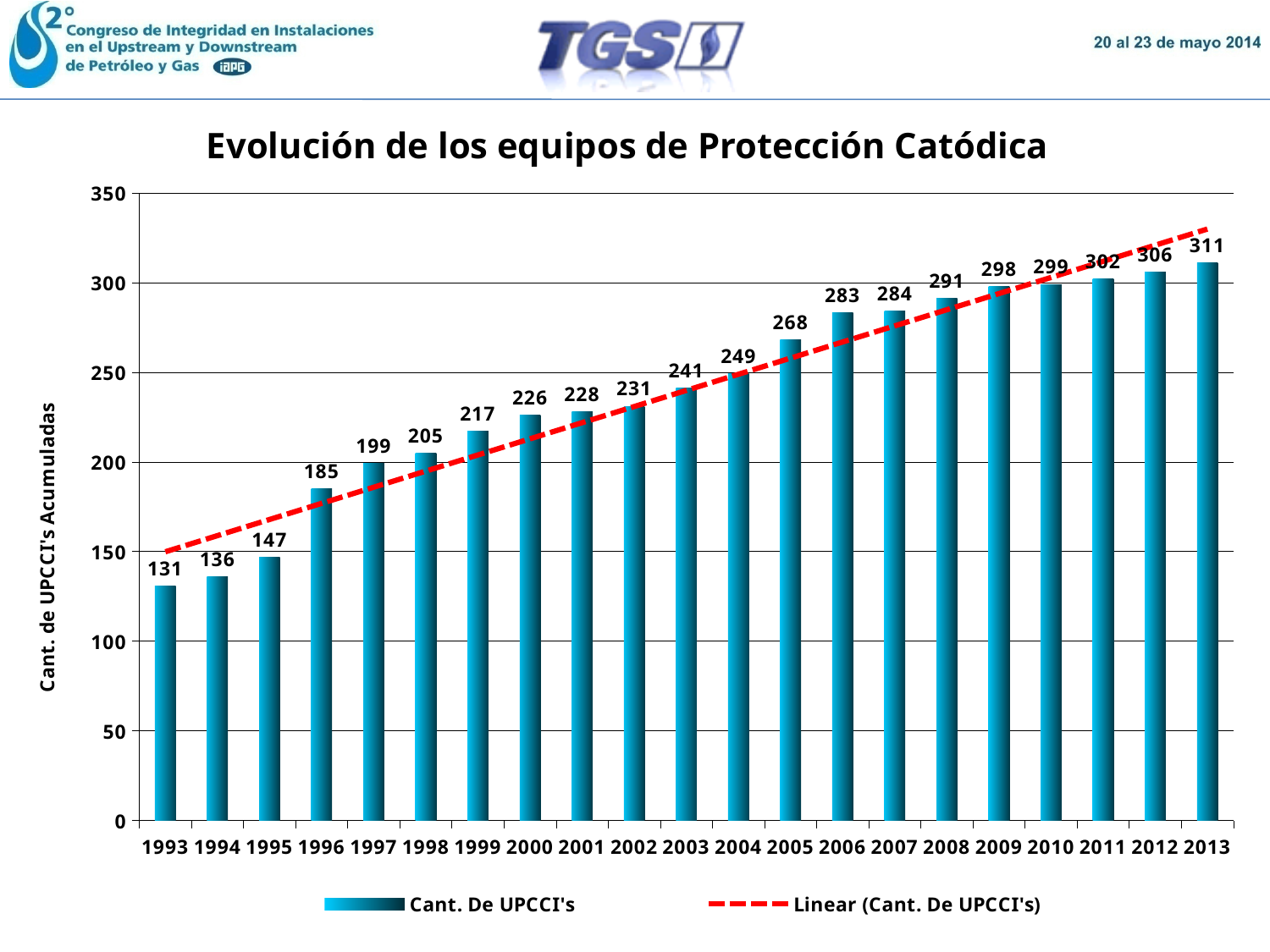
Which year has the lowest value? 1993 Which year has the highest value? 2013 What kind of chart is this? bar chart What is the difference between the values for 2013 and 1993? 180 Is the value for 2006 greater or less than 250? greater What is the difference between the values for 1996 and 1995? 38 Do the values rise or fall from 1993 to 2013? rise Which is larger, the value for 2000 or the value for 2003? 2003 What is the value for 2005? 268 How many years are shown on the x axis? 21 What is the value for 2013? 311 What is the value for 1993? 131